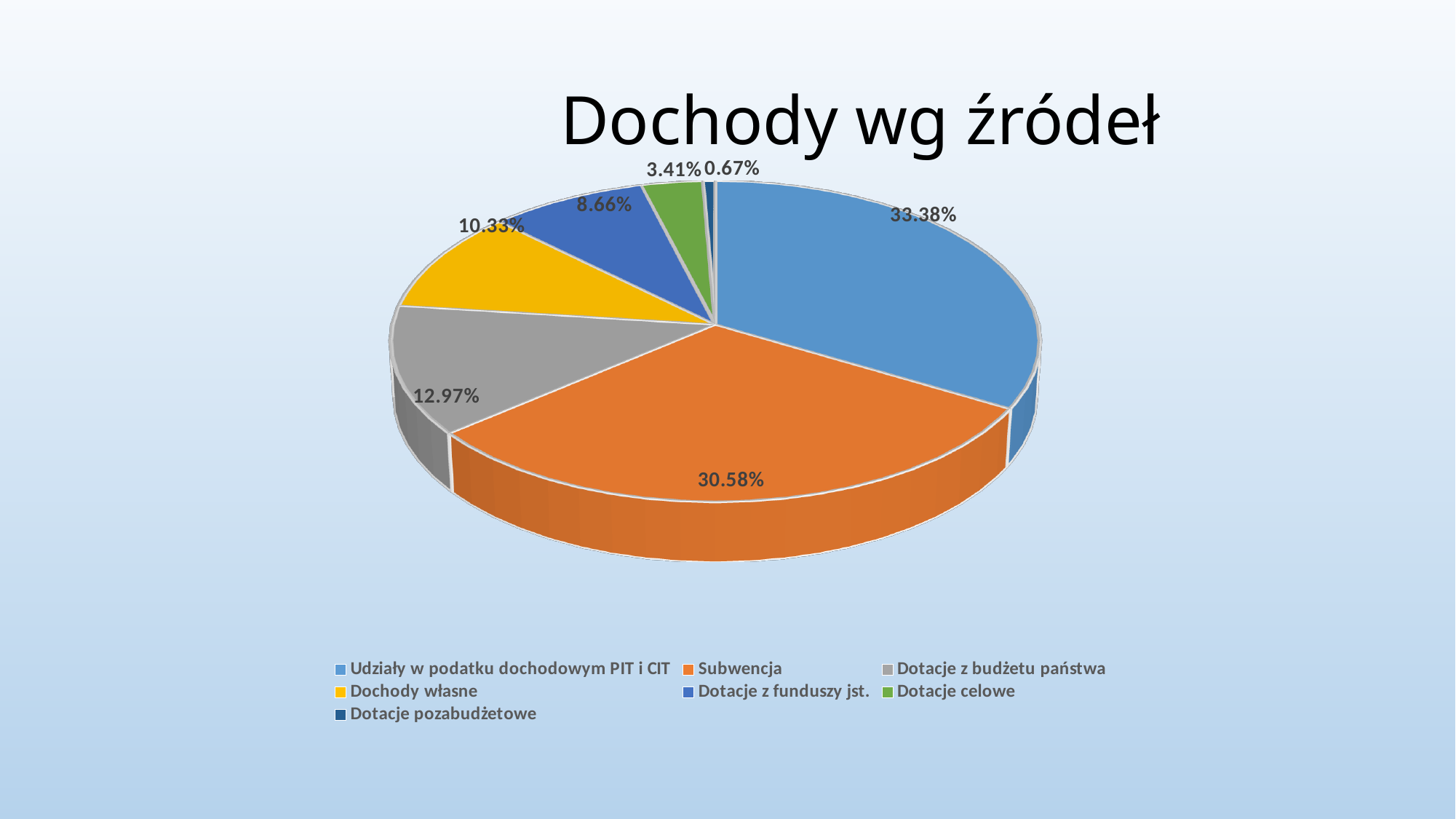
How many categories does the pie chart show? 7 What is the difference between the shares of Udziały w podatku dochodowym PIT i CIT and Subwencja? 2.80% What share of the pie does Dochody własne have? 10.33% What is the title of the chart? Dochody wg źródeł Which category has the largest share of the pie? Udziały w podatku dochodowym PIT i CIT Which has a larger share, Dotacje celowe or Dotacje z funduszy jst.? Dotacje z funduszy jst. What colour is the slice for Dochody własne? Yellow What share of the pie does Subwencja have? 30.58% What type of chart is shown on the slide? Pie chart What share of the pie does Dotacje z budżetu państwa have? 12.97% Which category has the smallest share of the pie? Dotacje pozabudżetowe